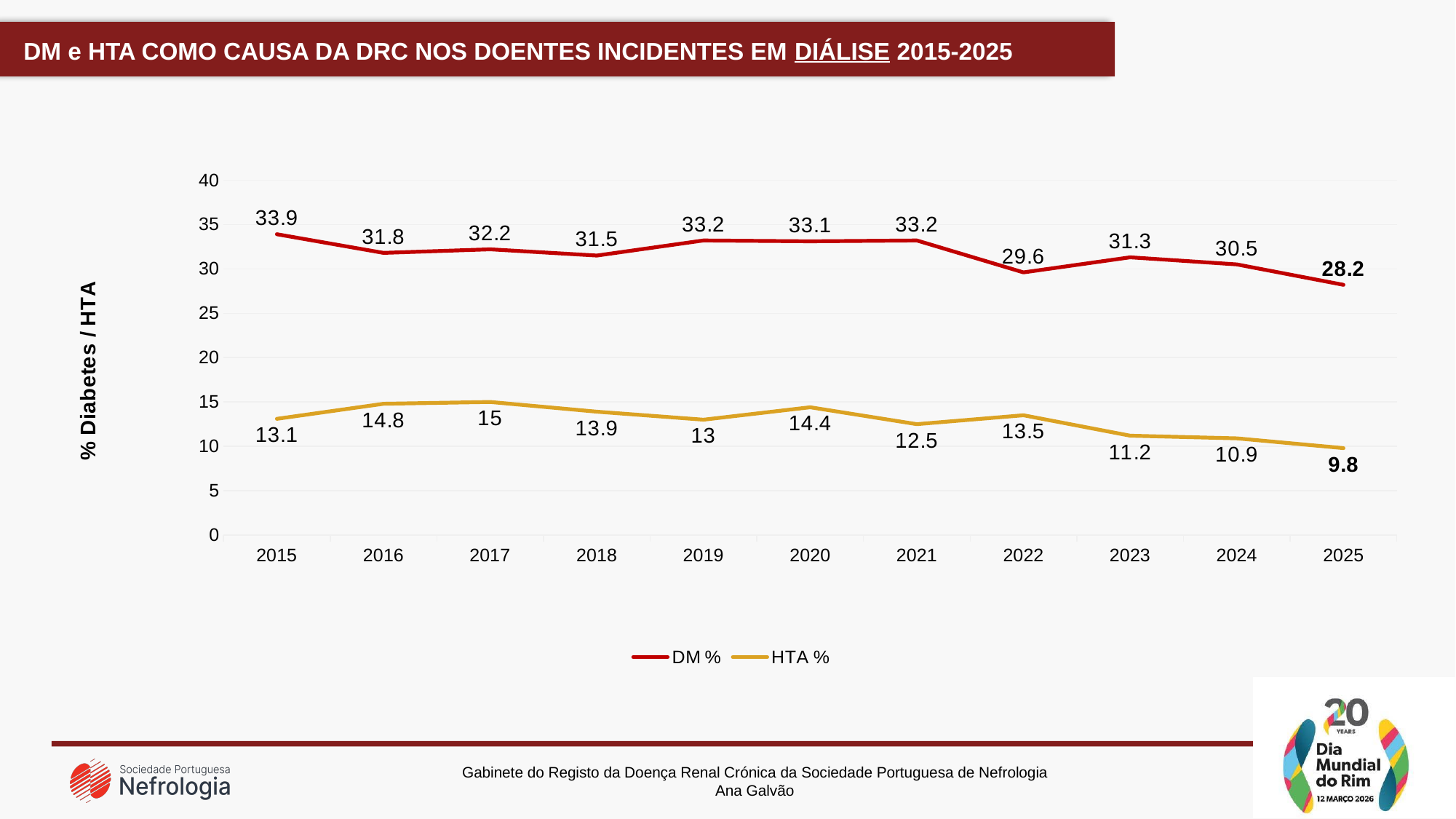
Which is larger, the HTA % value in 2016 or in 2023? 2016 How many series does the legend list? 2 What is the DM % value for 2015? 33.9 What colour is the DM % line? Red How many years are shown on the x axis? 11 What is the difference between the DM % value in 2015 and in 2025? 5.7 In which year is the DM % series at its lowest? 2025 Is the DM % value for 2022 greater or less than 30? less In which year is the HTA % series at its highest? 2017 What kind of chart is shown on the slide? Line chart What is the HTA % value for 2025? 9.8 What is the HTA % value for 2020? 14.4